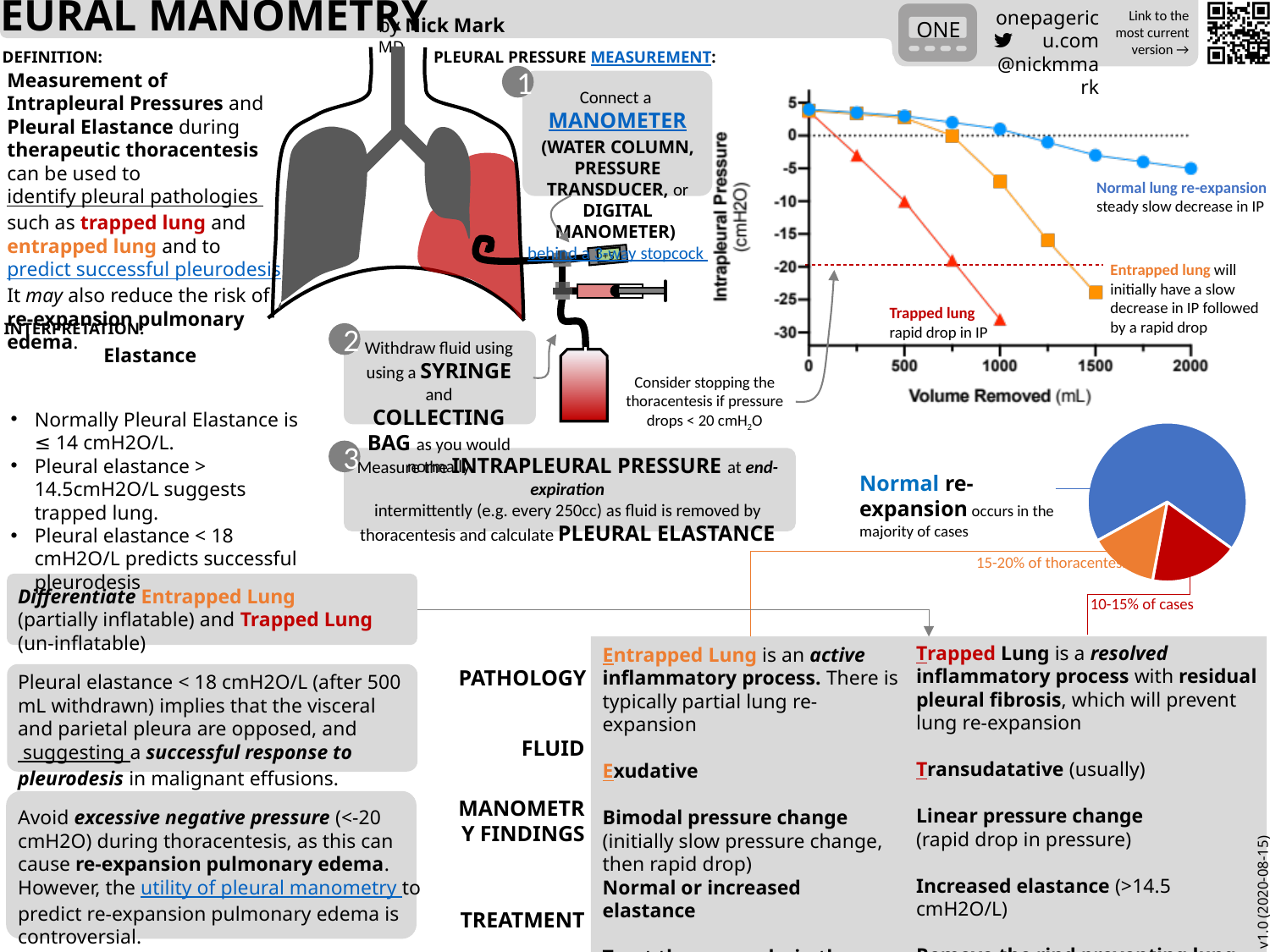
What is the x-axis label of the Intrapleural Pressure chart? Volume Removed (mL) On the Intrapleural Pressure chart, which lung type reaches the lowest intrapleural pressure? Trapped lung On the Intrapleural Pressure chart, is the Trapped lung value at 1000 mL removed greater or less than -20? less What kind of chart is the Intrapleural Pressure vs Volume Removed chart? line chart How many lines (lung types) are plotted on the Intrapleural Pressure vs Volume Removed chart? 3 In the pie chart, what share of cases is labelled for trapped lung (the red slice)? 10-15% In the pie chart, which outcome has the largest slice? Normal re-expansion On the Intrapleural Pressure chart, does the Normal lung re-expansion line rise or fall as volume removed increases? fall On the Intrapleural Pressure chart, is the Entrapped lung value at 1250 mL removed greater or less than -10? less What kind of chart is the chart on the right showing the proportion of re-expansion outcomes? pie chart On the Intrapleural Pressure chart, is the Normal lung re-expansion value at 2000 mL removed greater or less than -10? greater On the Intrapleural Pressure chart, at 1000 mL removed, which has the higher intrapleural pressure: Normal lung re-expansion or Trapped lung? Normal lung re-expansion